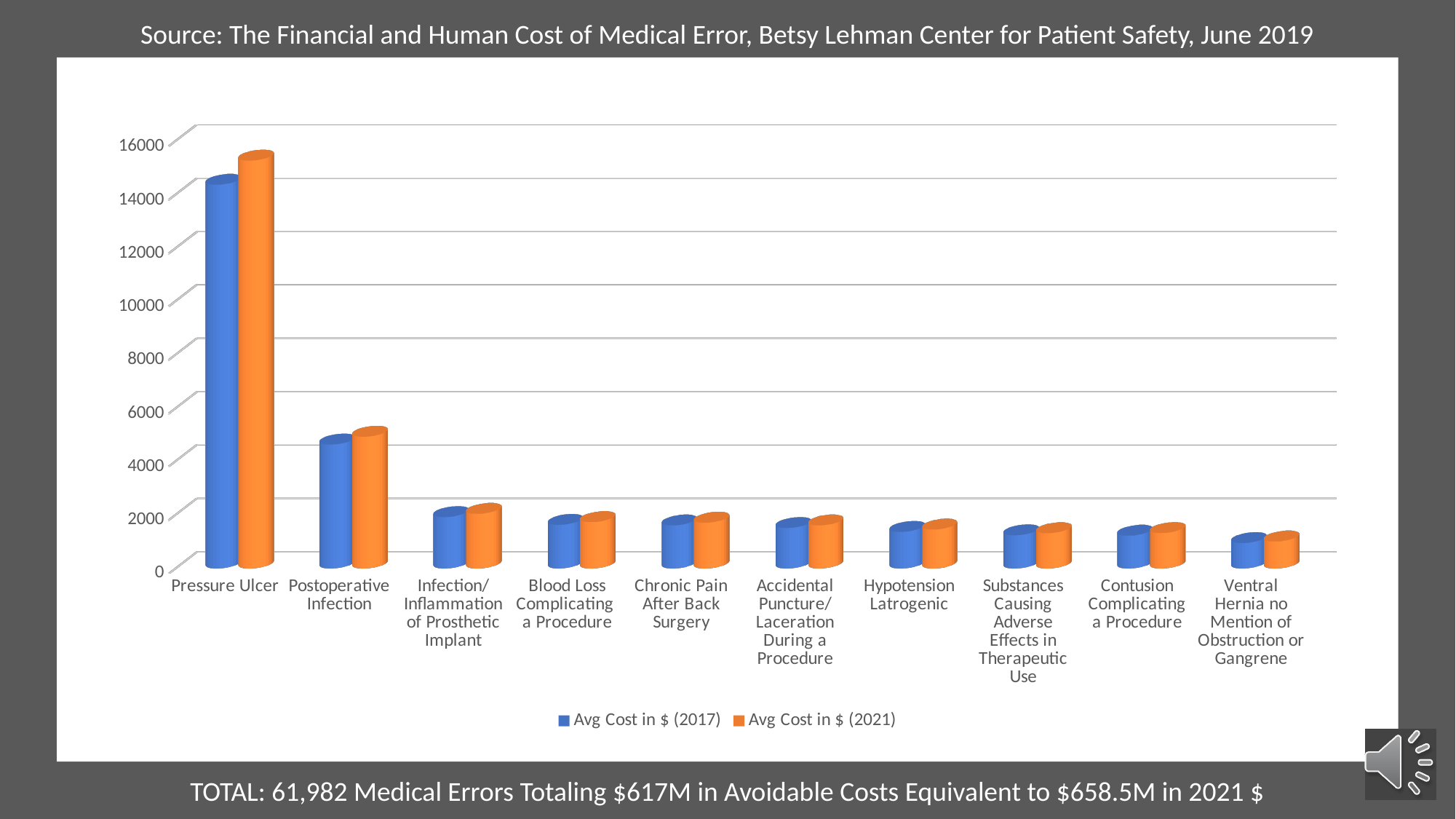
What kind of chart is shown on the slide? Bar chart How many categories of medical error are shown on the x axis? 10 Is the Avg Cost in $ (2017) for Ventral Hernia no Mention of Obstruction or Gangrene greater or less than 2000? less Is the Avg Cost in $ (2017) for Pressure Ulcer greater or less than 12000? greater Do the average costs generally rise or fall moving from left to right along the x axis? Fall Is the Avg Cost in $ (2021) for Pressure Ulcer greater or less than 14000? greater What colour represents the Avg Cost in $ (2021) series? Orange For Pressure Ulcer, which is larger: Avg Cost in $ (2017) or Avg Cost in $ (2021)? Avg Cost in $ (2021) Which category has the highest average cost? Pressure Ulcer Which category has the lowest average cost? Ventral Hernia no Mention of Obstruction or Gangrene How many series does the legend list? 2